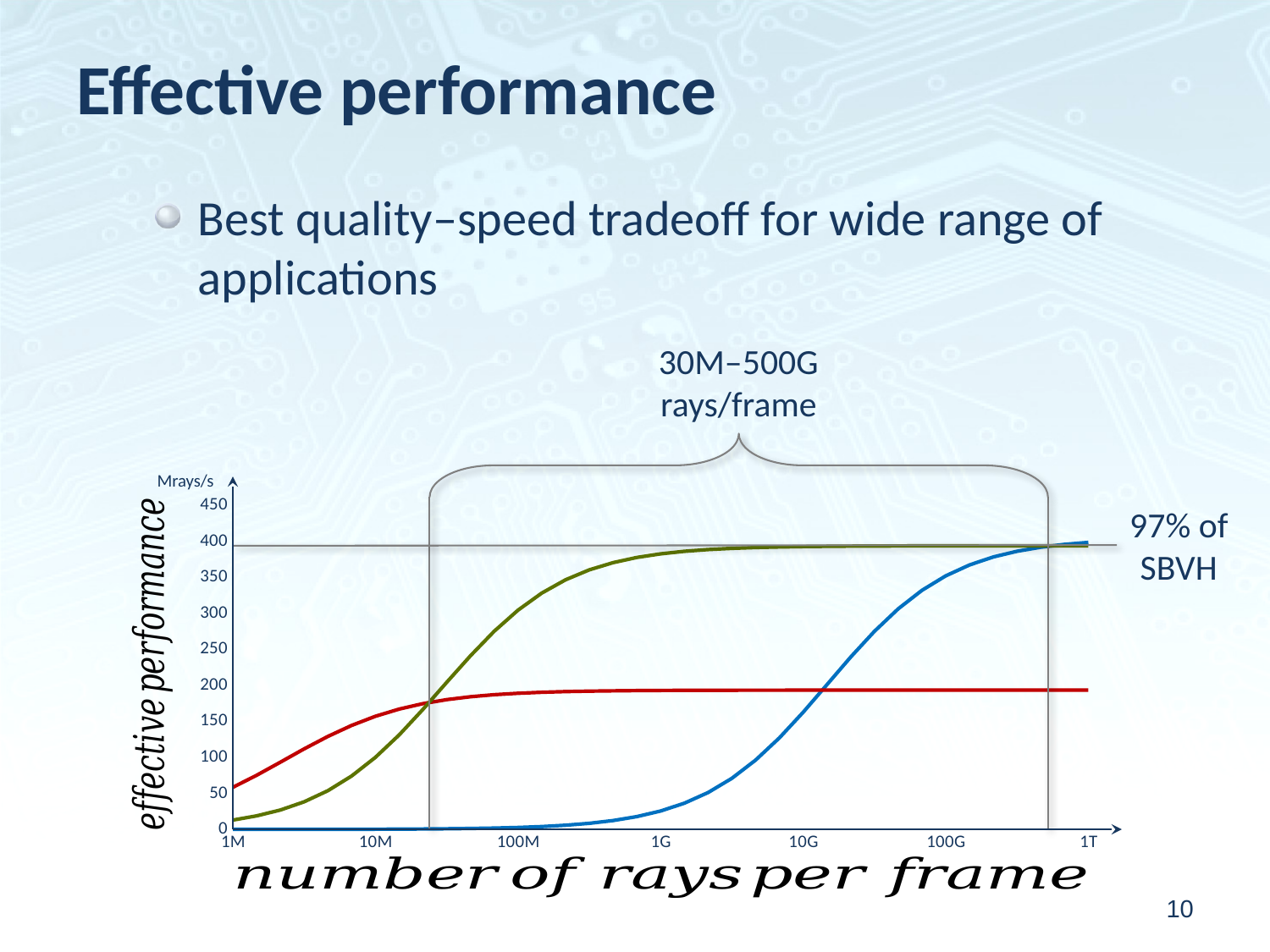
How many lines are plotted on the chart? 3 Which line has the lowest value at 1M rays per frame? blue line Is the value of the blue line at 100G rays per frame greater or less than 300 Mrays/s? greater At 10G rays per frame, which line is higher, the green line or the blue line? green line Does the blue line rise or fall as the number of rays per frame increases? rise Is the value of the red line at 100M rays per frame greater or less than 200 Mrays/s? less Is the value of the blue line at 1G rays per frame greater or less than 50 Mrays/s? less At 1M rays per frame, which line is higher, the red line or the green line? red line What unit is shown at the top of the y axis of the chart? Mrays/s What kind of chart is shown on the slide? line chart How many tick labels are shown on the x axis of the chart? 7